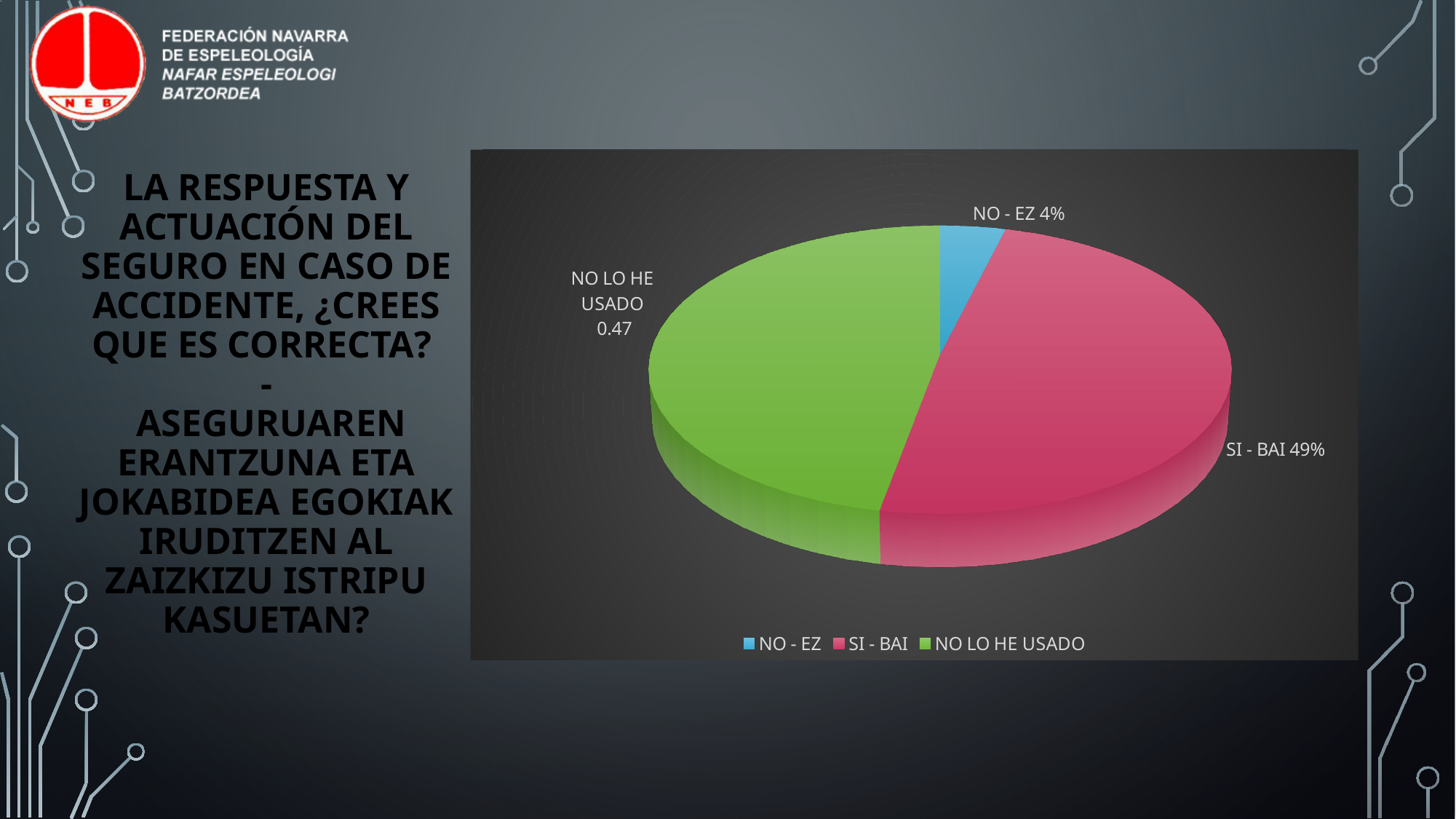
What value is printed on the NO LO HE USADO slice of the pie chart? 0.47 What percentage is shown for the SI - BAI slice of the pie chart? 49% Which slice of the pie chart is the smallest? NO - EZ How many slices does the pie chart have? 3 What kind of chart is shown on the slide? Pie chart What colour is the SI - BAI slice in the pie chart? Pink How many entries does the chart legend list? 3 What colour is the NO LO HE USADO slice in the pie chart? Green What is the difference in percentage points between the SI - BAI slice and the NO - EZ slice? 45% Which slice of the pie chart is the largest? SI - BAI What percentage is shown for the NO - EZ slice of the pie chart? 4% Which slice is larger, NO LO HE USADO or NO - EZ? NO LO HE USADO